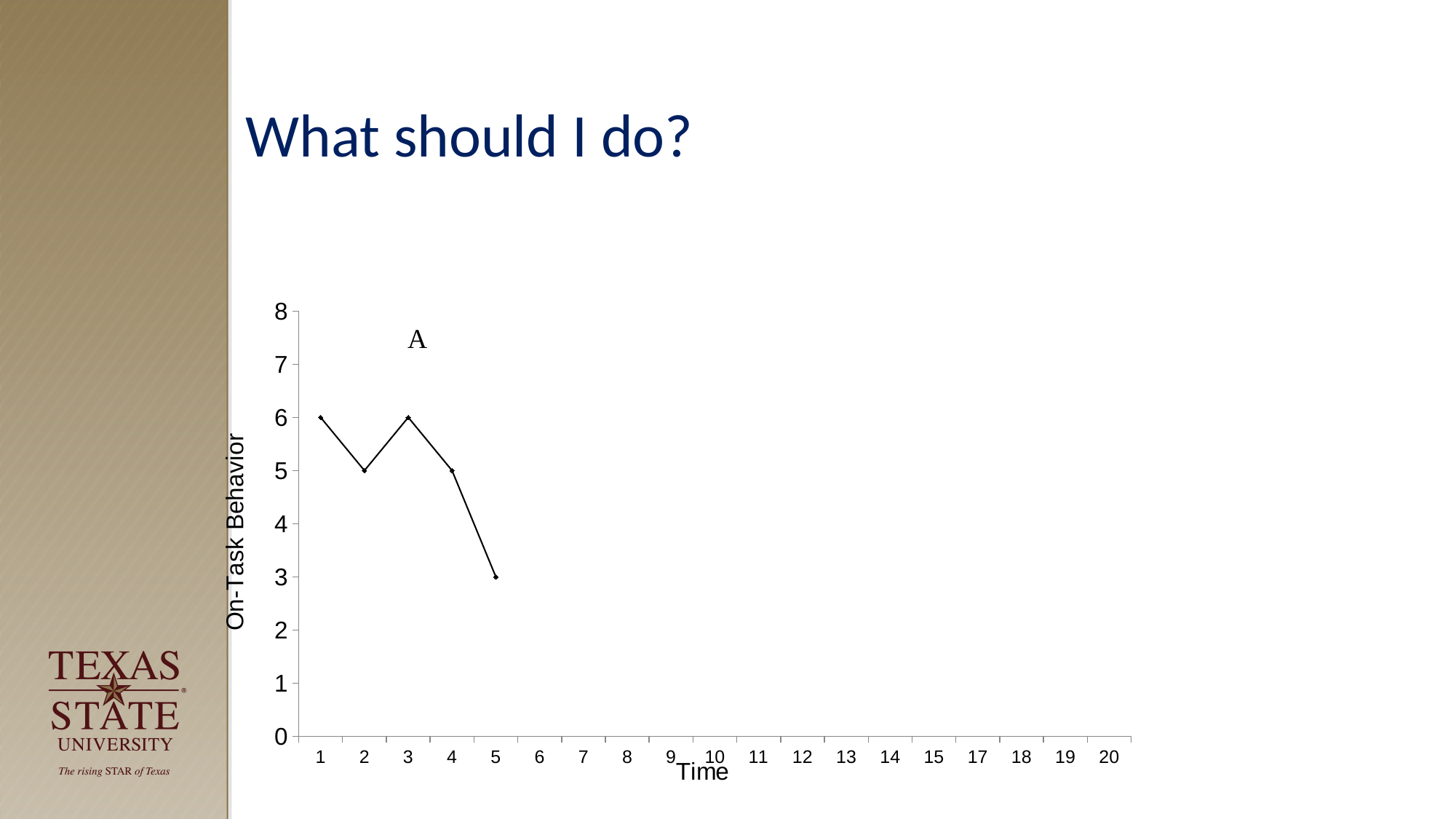
What kind of chart is shown on the slide? line chart Is the On-Task Behavior value at Time 5 greater or less than 4? less What is the On-Task Behavior value at Time 1? 6 How many data points are plotted on the chart? 5 What is the On-Task Behavior value at Time 3? 6 At which Time point is On-Task Behavior lowest? 5 What is the On-Task Behavior value at Time 5? 3 What is the difference between the On-Task Behavior values at Time 4 and Time 5? 2 What is the On-Task Behavior value at Time 2? 5 Which is larger, the On-Task Behavior value at Time 3 or at Time 4? Time 3 What is the label of the y axis? On-Task Behavior Overall, does On-Task Behavior rise or fall from Time 1 to Time 5? fall